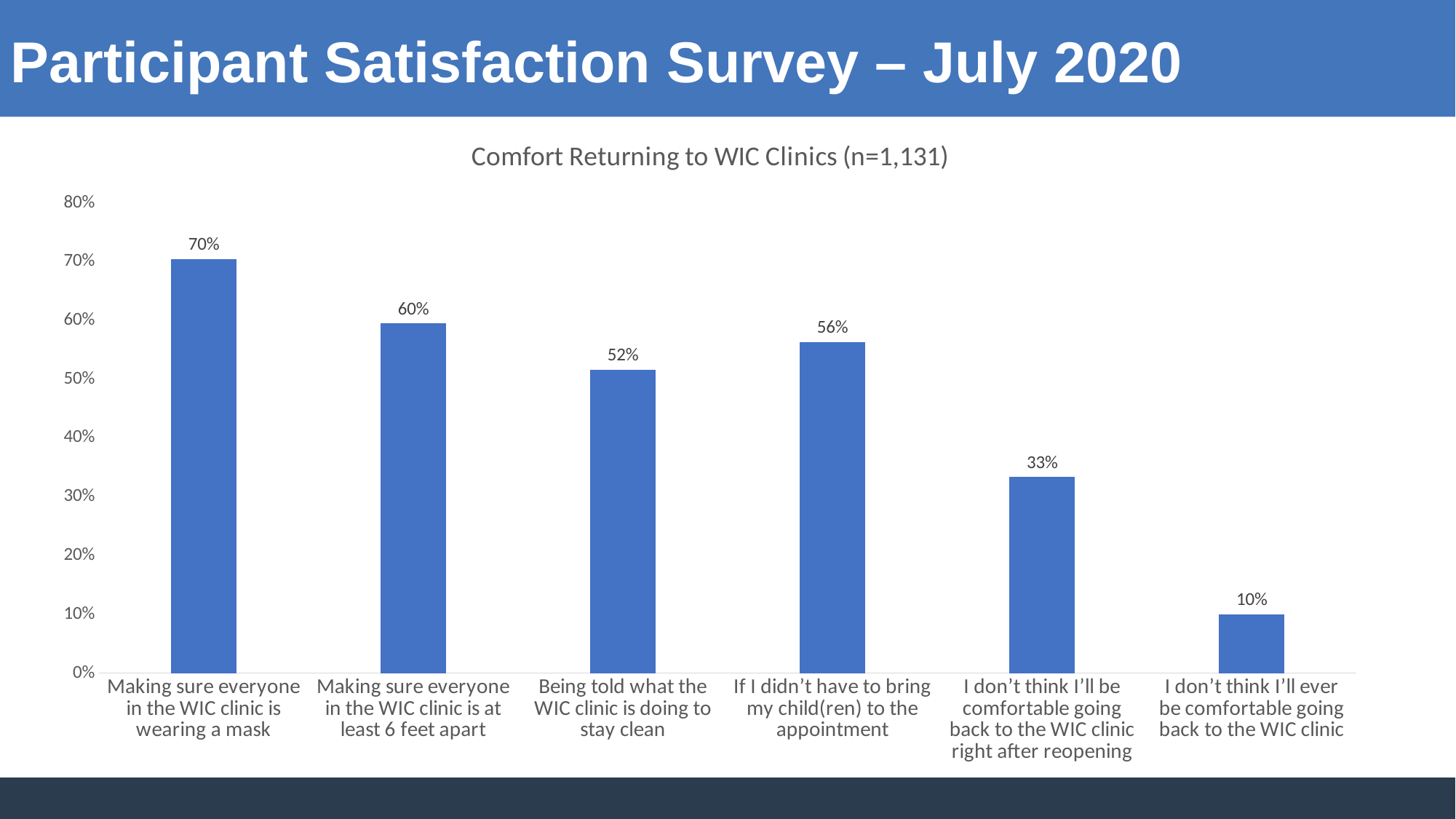
What percentage of respondents said making sure everyone in the WIC clinic is wearing a mask would make them comfortable returning? 70% Is the value for 'I don't think I'll be comfortable going back to the WIC clinic right after reopening' greater or less than 40%? less Which category has the highest value in the chart? Making sure everyone in the WIC clinic is wearing a mask What is the value for 'Being told what the WIC clinic is doing to stay clean'? 52% Which category has the lowest value in the chart? I don't think I'll ever be comfortable going back to the WIC clinic What is the sample size (n) given in the chart title? 1,131 What percentage said 'I don't think I'll ever be comfortable going back to the WIC clinic'? 10% How many categories are shown in the chart? 6 Which is larger: the value for 'Being told what the WIC clinic is doing to stay clean' or 'If I didn't have to bring my child(ren) to the appointment'? If I didn't have to bring my child(ren) to the appointment What kind of chart is shown on the slide? Bar chart What is the difference between the value for 'Making sure everyone in the WIC clinic is at least 6 feet apart' and 'If I didn't have to bring my child(ren) to the appointment'? 4%